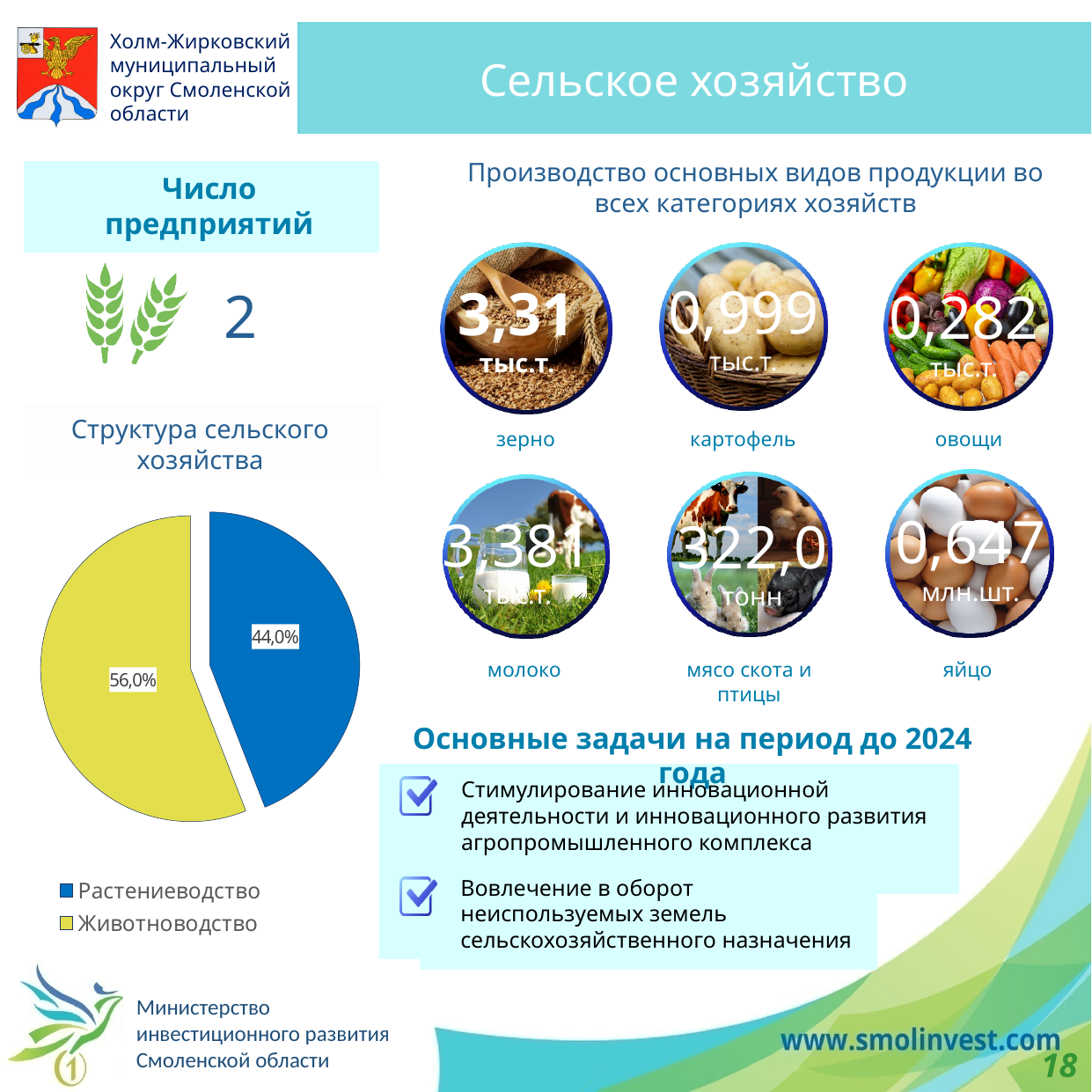
In the pie chart "Структура сельского хозяйства", what is the value for Животноводство? 56,0% In the pie chart "Структура сельского хозяйства", what is the difference in percentage points between Животноводство and Растениеводство? 12,0 How many entries does the legend of the pie chart "Структура сельского хозяйства" list? 2 In the pie chart "Структура сельского хозяйства", which colour represents Растениеводство? blue In the pie chart "Структура сельского хозяйства", which is larger: Растениеводство or Животноводство? Животноводство In the pie chart "Структура сельского хозяйства", which colour represents Животноводство? yellow What kind of chart is shown under the heading "Структура сельского хозяйства"? pie chart In the pie chart "Структура сельского хозяйства", which category has the smallest share? Растениеводство In the pie chart "Структура сельского хозяйства", which category has the largest share? Животноводство In the pie chart "Структура сельского хозяйства", what is the value for Растениеводство? 44,0% In the pie chart "Структура сельского хозяйства", what share of the pie does Животноводство take? 56,0% How many slices does the pie chart "Структура сельского хозяйства" have? 2